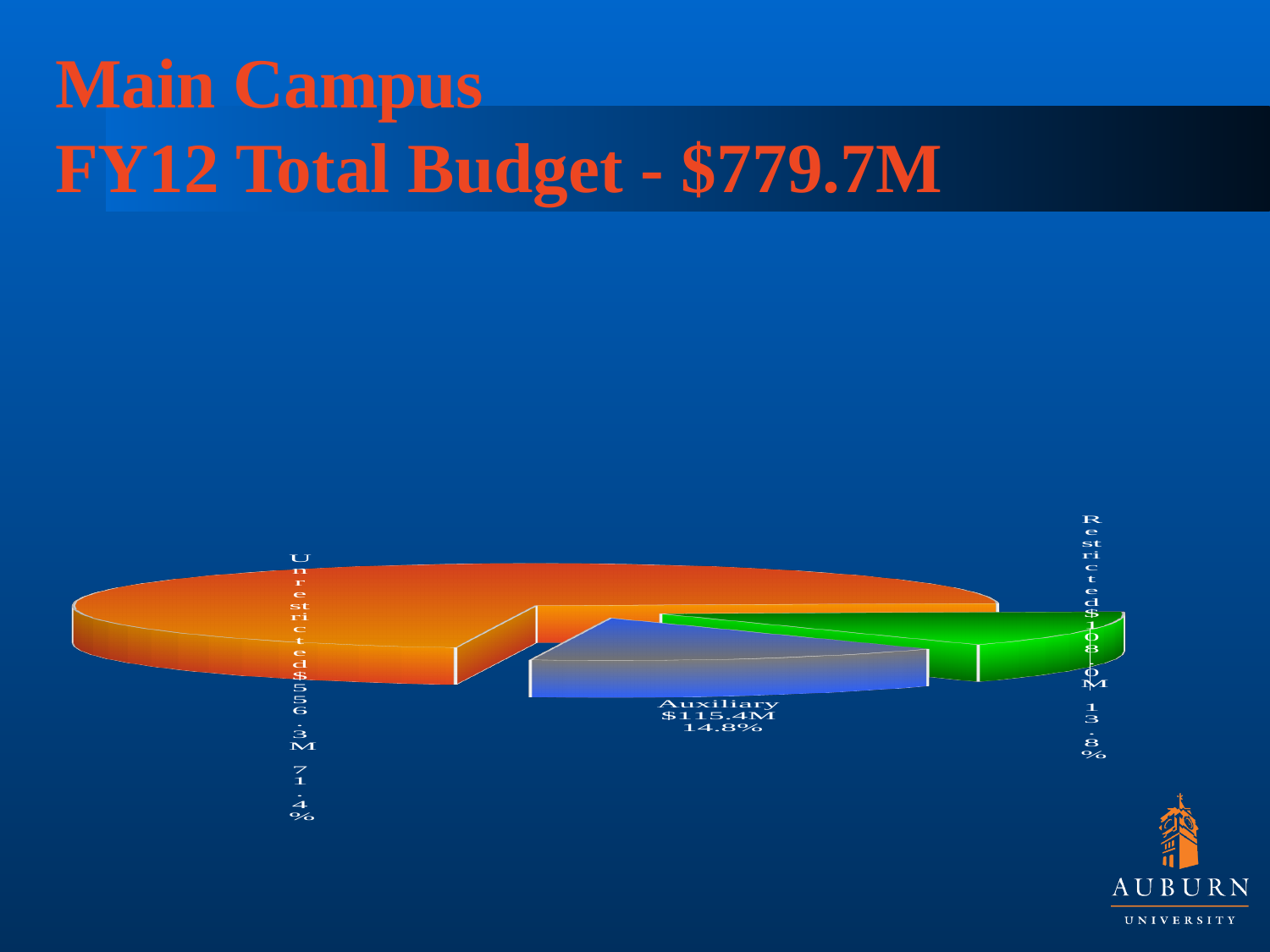
What is the dollar value of the Auxiliary slice? $115.4M What share of the pie does the Unrestricted slice represent? 71.4% What share of the pie does the Auxiliary slice represent? 14.8% How many slices does the pie chart have? 3 Which slice is the largest? Unrestricted What share of the pie does the Restricted slice represent? 13.8% What kind of chart is shown on the slide? pie chart What total budget is stated in the slide title? $779.7M Which slice is the smallest? Restricted What is the dollar value of the Restricted slice? $108.0M What is the difference in dollar value between the Unrestricted and Auxiliary slices? $440.9M What is the dollar value of the Unrestricted slice? $556.3M